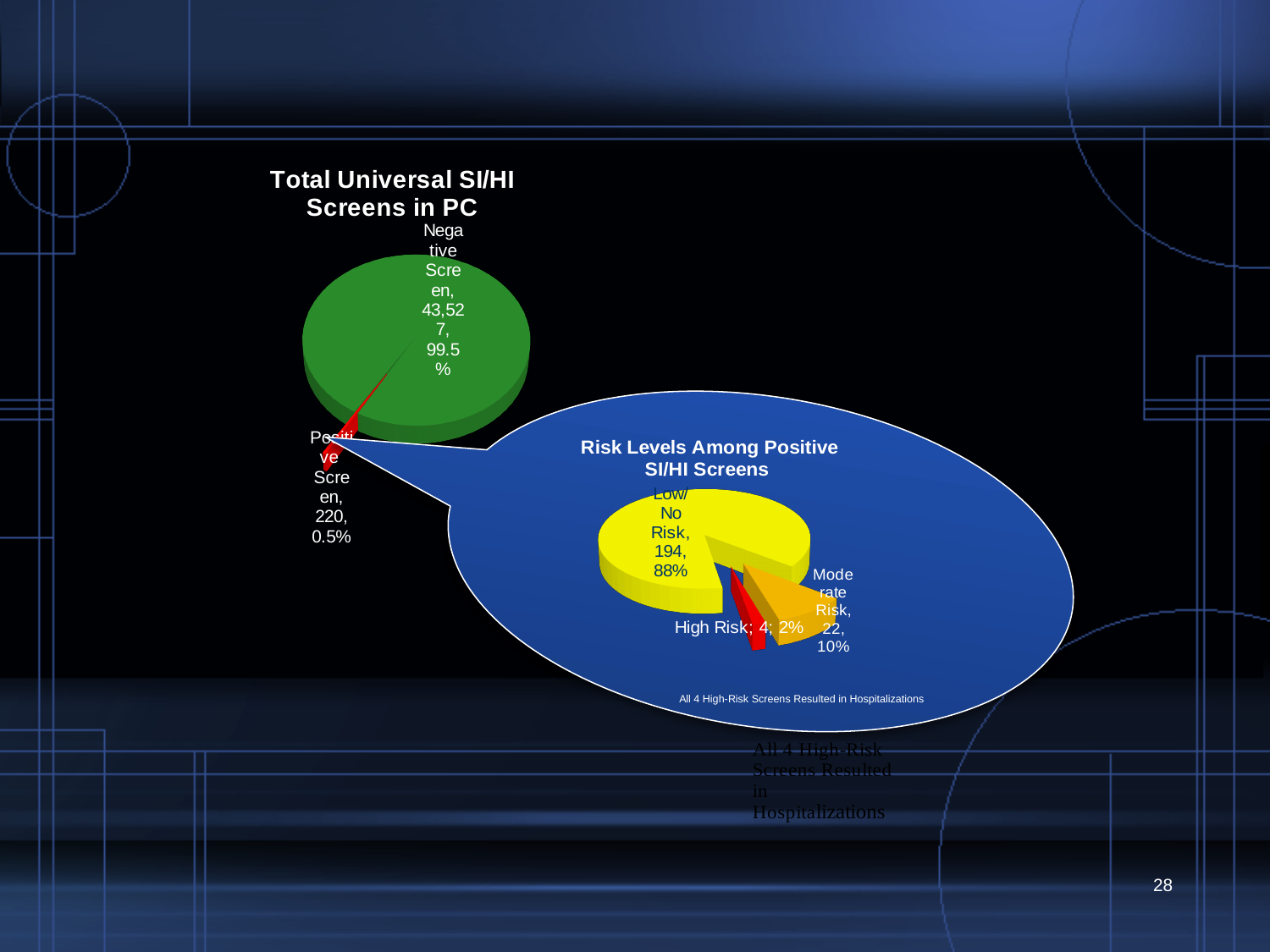
In the 'Risk Levels Among Positive SI/HI Screens' chart, which risk level has the smallest slice? High Risk In the 'Total Universal SI/HI Screens in PC' chart, which category has the larger slice? Negative Screen In the 'Risk Levels Among Positive SI/HI Screens' chart, what is the difference between the Moderate Risk count and the High Risk count? 18 In the 'Total Universal SI/HI Screens in PC' chart, what percentage of screens were Positive Screens? 0.5% In the 'Risk Levels Among Positive SI/HI Screens' chart, what share of the pie is Moderate Risk? 10% In the 'Risk Levels Among Positive SI/HI Screens' chart, how many screens were High Risk? 4 In the 'Risk Levels Among Positive SI/HI Screens' chart, how many screens were Low/No Risk? 194 In the 'Total Universal SI/HI Screens in PC' chart, how many Positive Screens are shown? 220 In the 'Total Universal SI/HI Screens in PC' chart, how many Negative Screens are shown? 43,527 What type of chart is 'Total Universal SI/HI Screens in PC'? Pie chart In the 'Risk Levels Among Positive SI/HI Screens' chart, what colour is the Low/No Risk slice? Yellow In the 'Risk Levels Among Positive SI/HI Screens' chart, how many categories are shown? 3